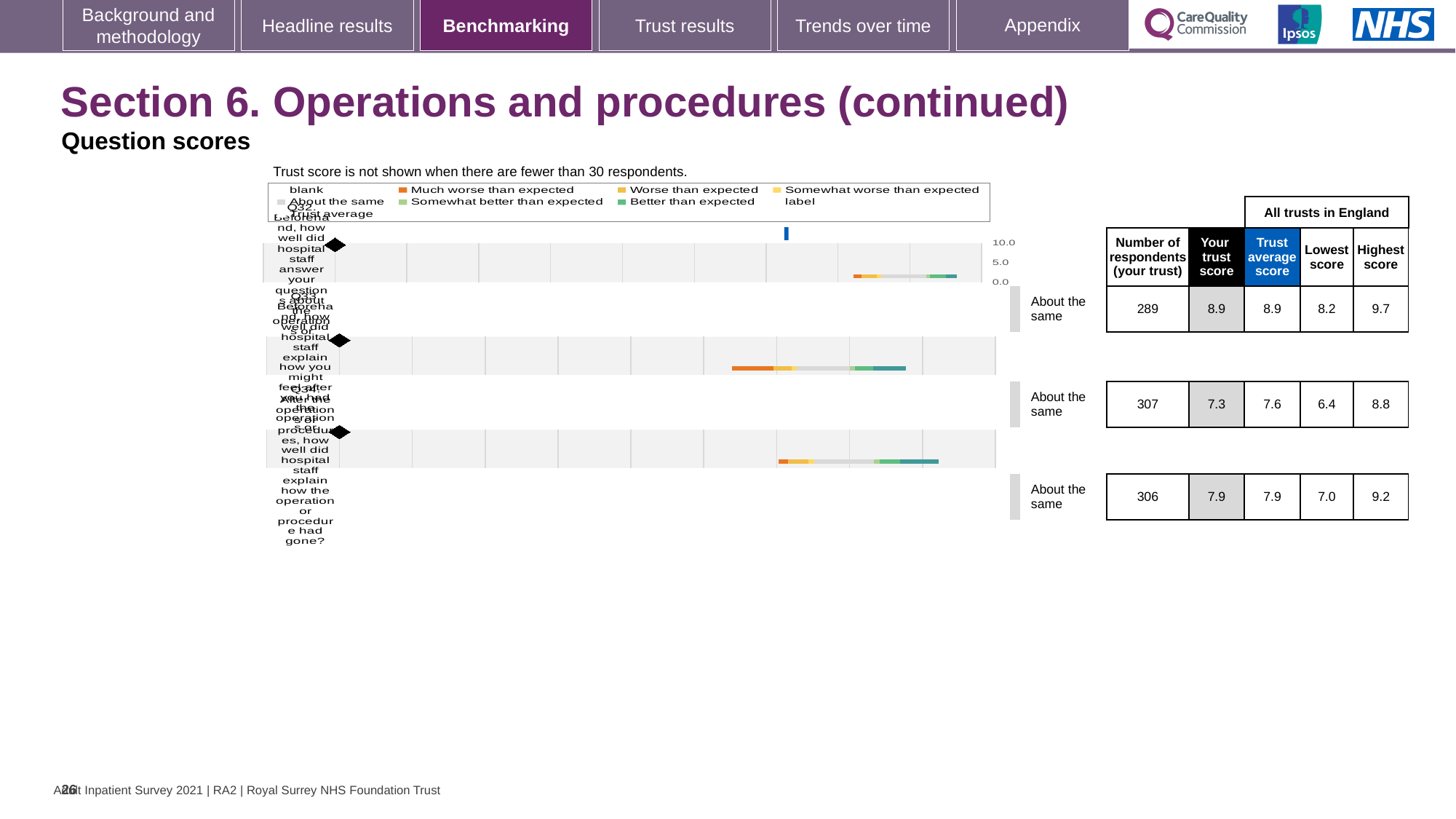
What is the difference between the trust average score and your trust score for the second question row? 0.3 What is the highest score across all trusts in England for the first question row? 9.7 How many question rows are shown in the benchmarking table? 3 What benchmark category is shown for each of the three question rows? About the same What is the trust average score for the third question row in the table? 7.9 Which is larger for the third question row: the highest score or the lowest score? Highest score (9.2) Which question row has the lowest 'Your trust score'? The second row (7.3) What is the number of respondents for the first question row in the table? 289 What is the lowest score across all trusts in England for the second question row? 6.4 What kind of chart is used to show the benchmarking results? Bar chart Which question row has the highest 'Your trust score'? The first row (8.9) What is the 'Your trust score' for the second question row in the table? 7.3